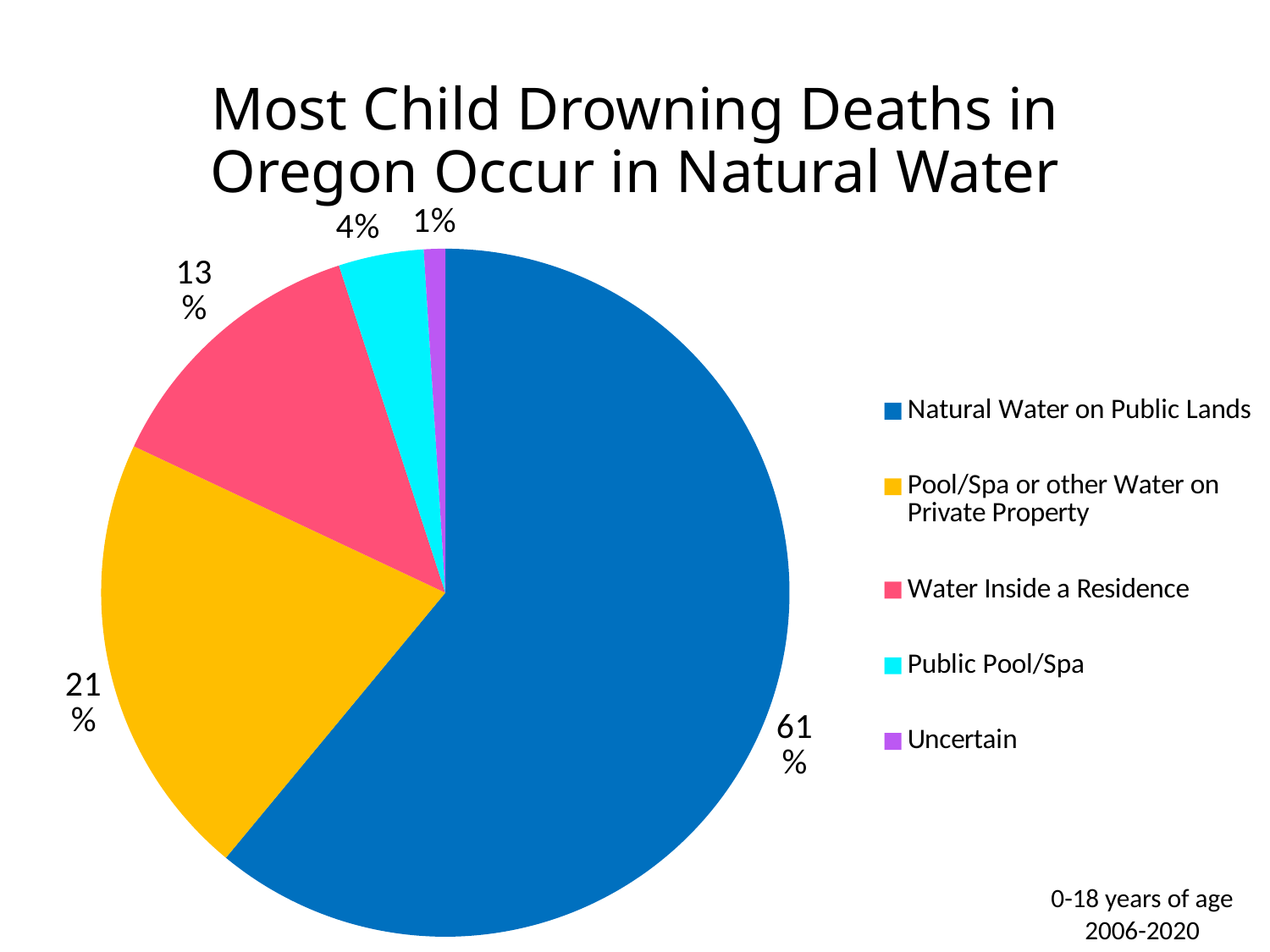
Which is larger: Water Inside a Residence or Public Pool/Spa? Water Inside a Residence What is the difference in percentage points between Natural Water on Public Lands and Pool/Spa or other Water on Private Property? 40 What percentage is shown for Water Inside a Residence? 13% What share of child drowning deaths occurred in Natural Water on Public Lands? 61% What percentage is shown for Public Pool/Spa? 4% What percentage is shown for Pool/Spa or other Water on Private Property? 21% What type of chart is shown on the slide? pie chart What is the title of the chart? Most Child Drowning Deaths in Oregon Occur in Natural Water Which category has the smallest slice of the pie? Uncertain What percentage is shown for Uncertain? 1% How many categories does the legend list? 5 Which category has the largest slice of the pie? Natural Water on Public Lands